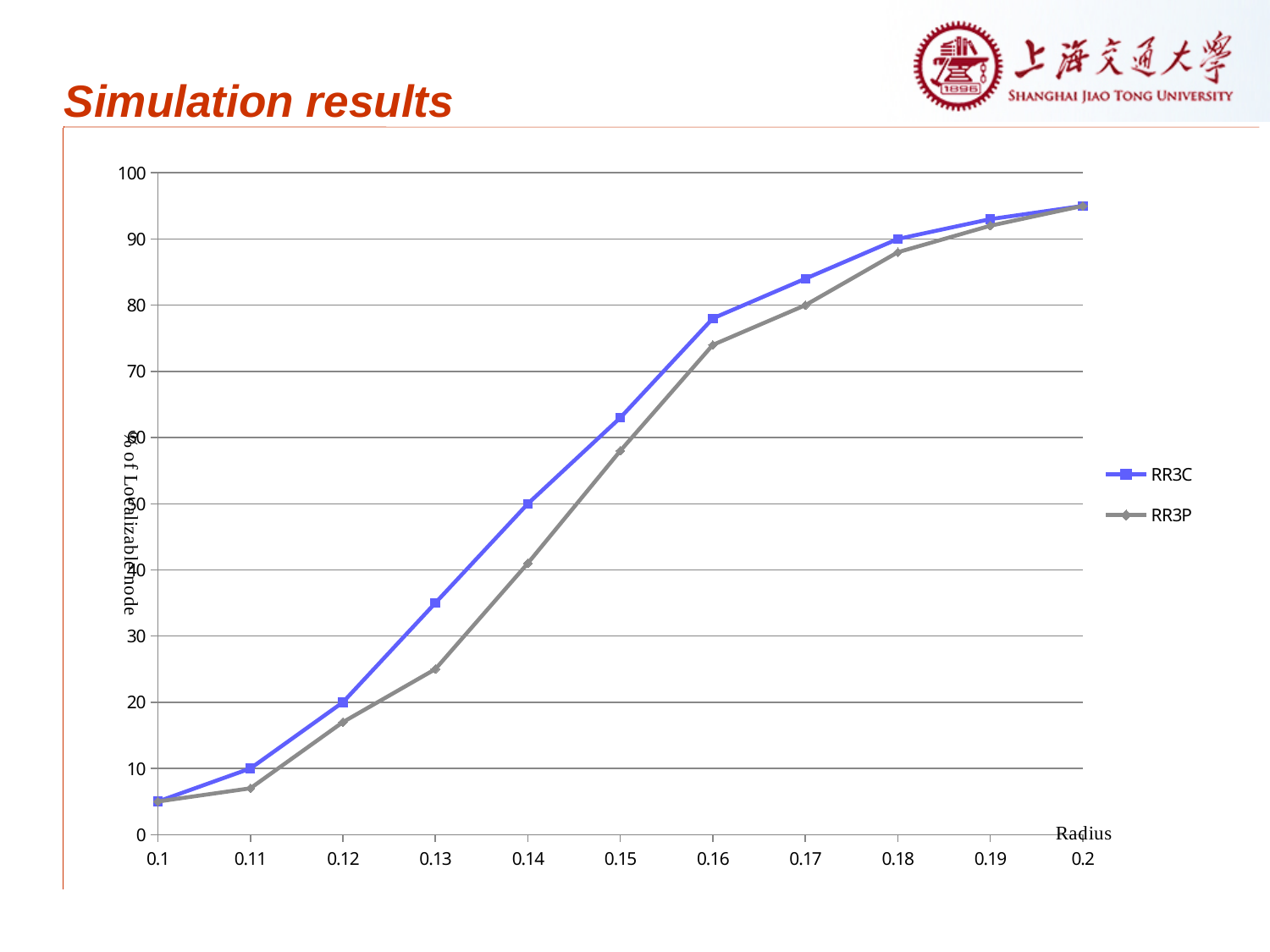
What kind of chart is shown on the slide? line chart What is the value for RR3C at radius 0.14? 50 What is the value for RR3C at radius 0.12? 20 Do the values for RR3C rise or fall as the radius increases? rise What is the value for RR3P at radius 0.17? 80 Is the value for RR3C at radius 0.16 greater or less than 70? greater What is the value for RR3C at radius 0.18? 90 What is the label of the x axis? Radius How many radius values are plotted along the x axis? 11 Is the value for RR3P at radius 0.15 greater or less than 60? less How many series does the legend list? 2 At radius 0.13, which series has the larger value, RR3C or RR3P? RR3C